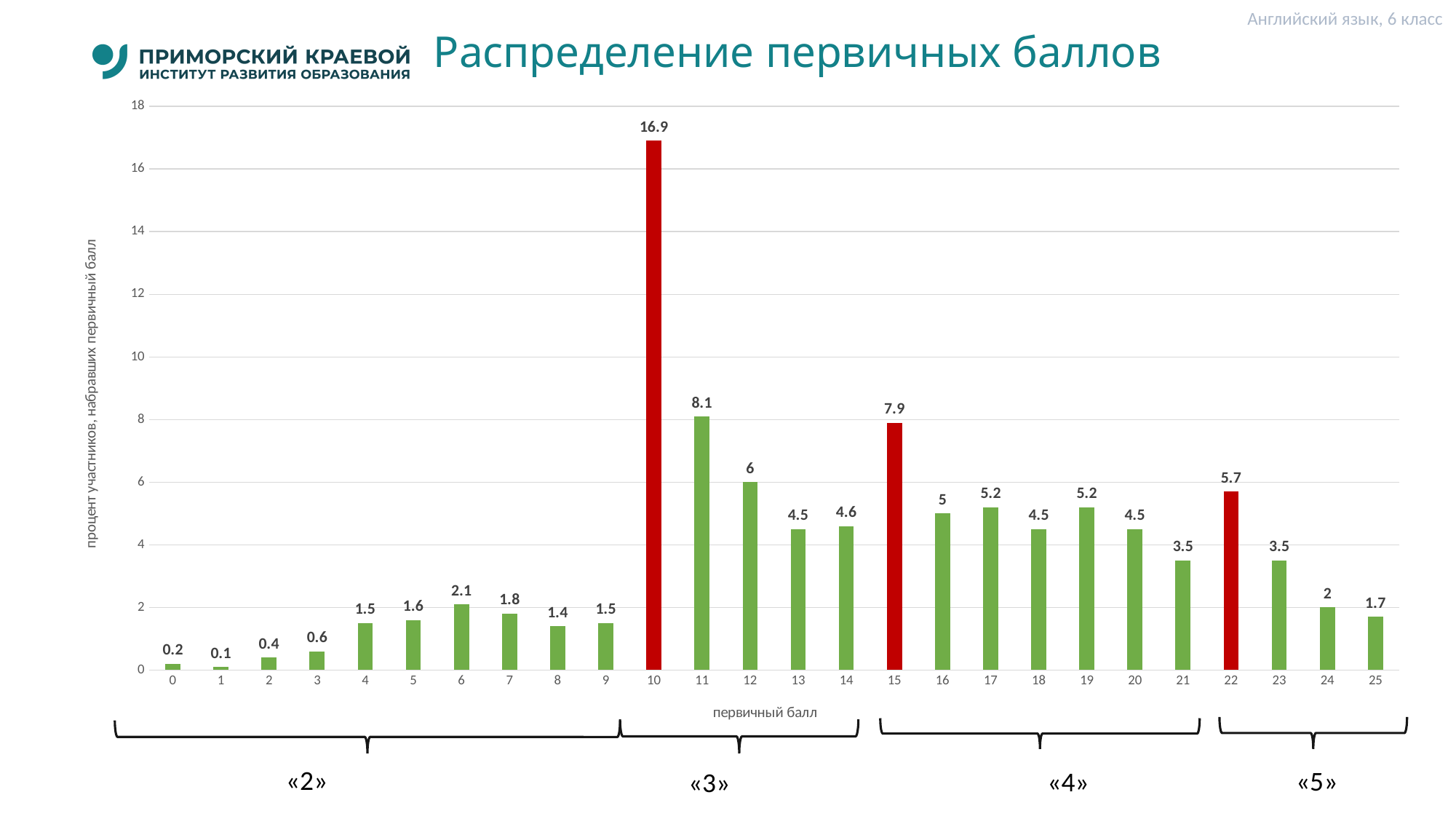
Which primary scores are shown with red bars? 10, 15, 22 Which is larger, the value for primary score 12 or for primary score 16? 12 Which primary score has the lowest percentage of participants? 1 How many primary score categories are shown on the x axis? 26 What is the value for primary score 6? 2.1 What is the difference between the values for primary scores 15 and 14? 3.3 What type of chart is shown on the slide? bar chart What is the title of the chart? Распределение первичных баллов Which primary score has the highest percentage of participants? 10 What is the value for primary score 10? 16.9 What is the value for primary score 22? 5.7 What is the difference between the values for primary scores 10 and 11? 8.8